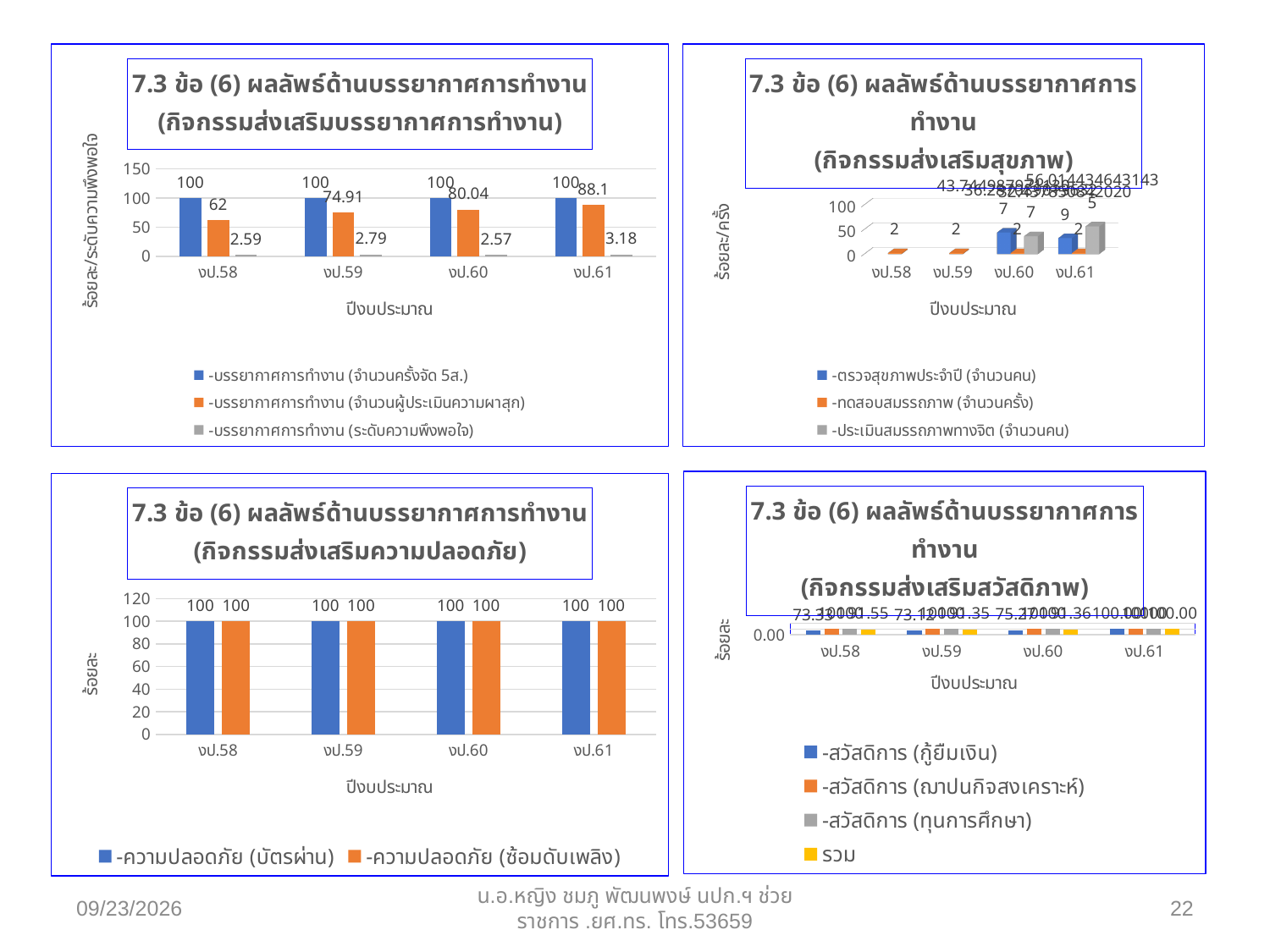
In the top-left chart (กิจกรรมส่งเสริมบรรยากาศการทำงาน), which year has the highest value for the orange series (จำนวนผู้ประเมินความผาสุก)? งป.61 In the bottom-left chart (กิจกรรมส่งเสริมความปลอดภัย), what is the value of the blue series (บัตรผ่าน) for งป.60? 100 In the top-right chart (กิจกรรมส่งเสริมสุขภาพ), what is the label of the orange series in the legend? -ทดสอบสมรรถภาพ (จำนวนครั้ง) In the bottom-right chart (กิจกรรมส่งเสริมสวัสดิภาพ), how many series does the legend list? 4 In the top-left chart (กิจกรรมส่งเสริมบรรยากาศการทำงาน), does the orange series (จำนวนผู้ประเมินความผาสุก) rise or fall from งป.58 to งป.61? rise In the top-left chart (กิจกรรมส่งเสริมบรรยากาศการทำงาน), how many series does the legend list? 3 In the top-left chart (กิจกรรมส่งเสริมบรรยากาศการทำงาน), which year has the lowest value for the gray series (ระดับความพึงพอใจ)? งป.60 In the top-left chart (กิจกรรมส่งเสริมบรรยากาศการทำงาน), what is the difference between the orange series values for งป.61 and งป.58? 26.1 In the top-left chart (กิจกรรมส่งเสริมบรรยากาศการทำงาน), what is the value of the orange series (จำนวนผู้ประเมินความผาสุก) for งป.59? 74.91 In the top-left chart (กิจกรรมส่งเสริมบรรยากาศการทำงาน), what is the value of the gray series (ระดับความพึงพอใจ) for งป.61? 3.18 What kind of chart is the bottom-left chart (กิจกรรมส่งเสริมความปลอดภัย)? bar chart In the bottom-left chart (กิจกรรมส่งเสริมความปลอดภัย), how many years are shown on the x axis? 4